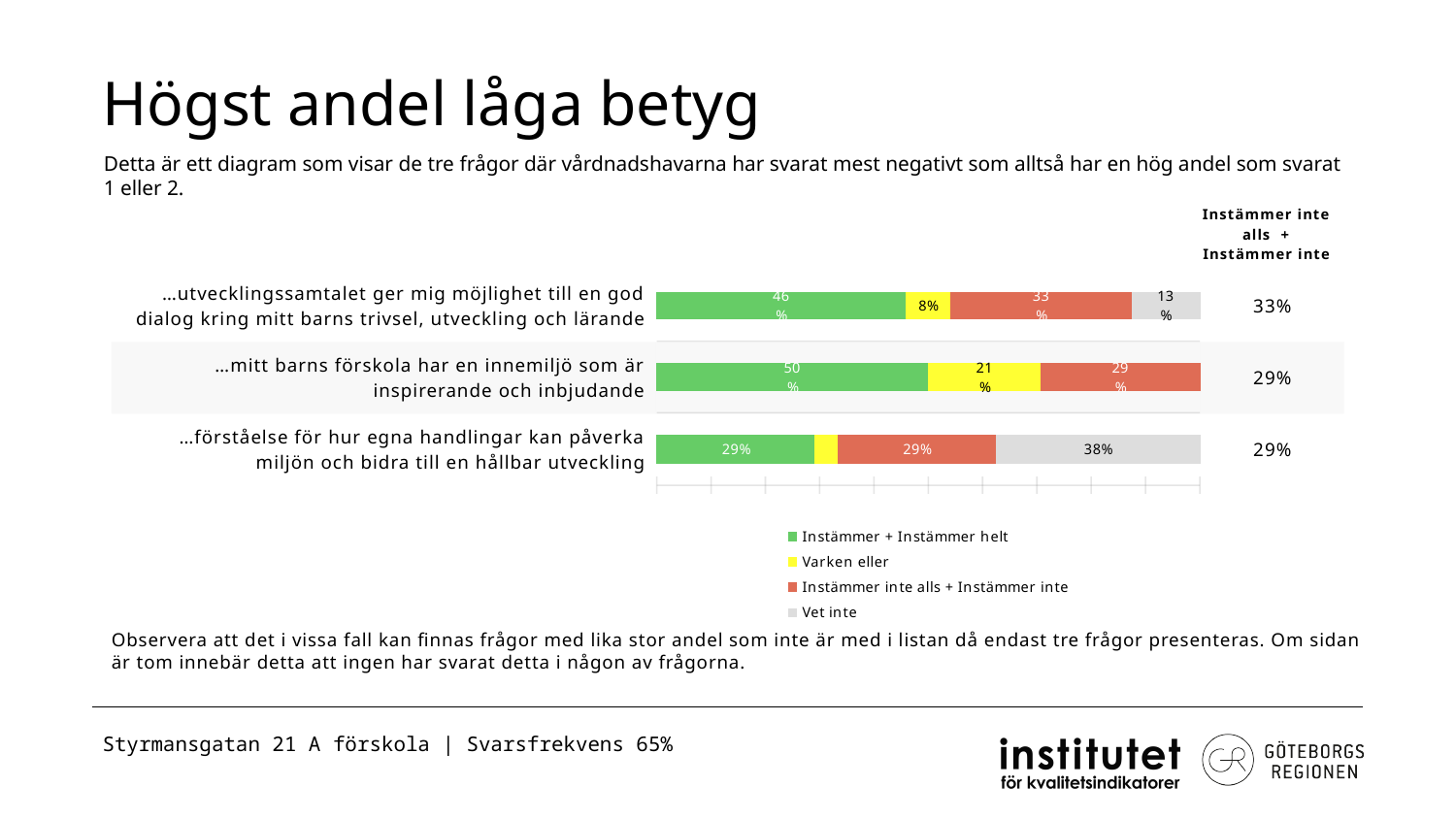
What is the value of 'Instämmer + Instämmer helt' for '…mitt barns förskola har en innemiljö som är inspirerande och inbjudande'? 50% Which category has the highest 'Instämmer + Instämmer helt' share? …mitt barns förskola har en innemiljö som är inspirerande och inbjudande Which is larger: the 'Varken eller' value for '…mitt barns förskola har en innemiljö som är inspirerande och inbjudande' or for '…utvecklingssamtalet ger mig möjlighet till en god dialog kring mitt barns trivsel, utveckling och lärande'? …mitt barns förskola har en innemiljö som är inspirerande och inbjudande What colour represents 'Vet inte' in the chart? grey How many categories (questions) are plotted in the chart? 3 What is the value of 'Vet inte' for '…förståelse för hur egna handlingar kan påverka miljön och bidra till en hållbar utveckling'? 38% What is the difference between the 'Instämmer + Instämmer helt' values for '…mitt barns förskola har en innemiljö som är inspirerande och inbjudande' and '…utvecklingssamtalet ger mig möjlighet till en god dialog kring mitt barns trivsel, utveckling och lärande'? 4% What is the 'Instämmer inte alls + Instämmer inte' value shown in the right-hand column for '…utvecklingssamtalet ger mig möjlighet till en god dialog kring mitt barns trivsel, utveckling och lärande'? 33% What is the value of 'Varken eller' for '…utvecklingssamtalet ger mig möjlighet till en god dialog kring mitt barns trivsel, utveckling och lärande'? 8% Which category has the lowest 'Instämmer + Instämmer helt' share? …förståelse för hur egna handlingar kan påverka miljön och bidra till en hållbar utveckling What kind of chart is shown on the slide? stacked bar chart How many series does the legend list? 4